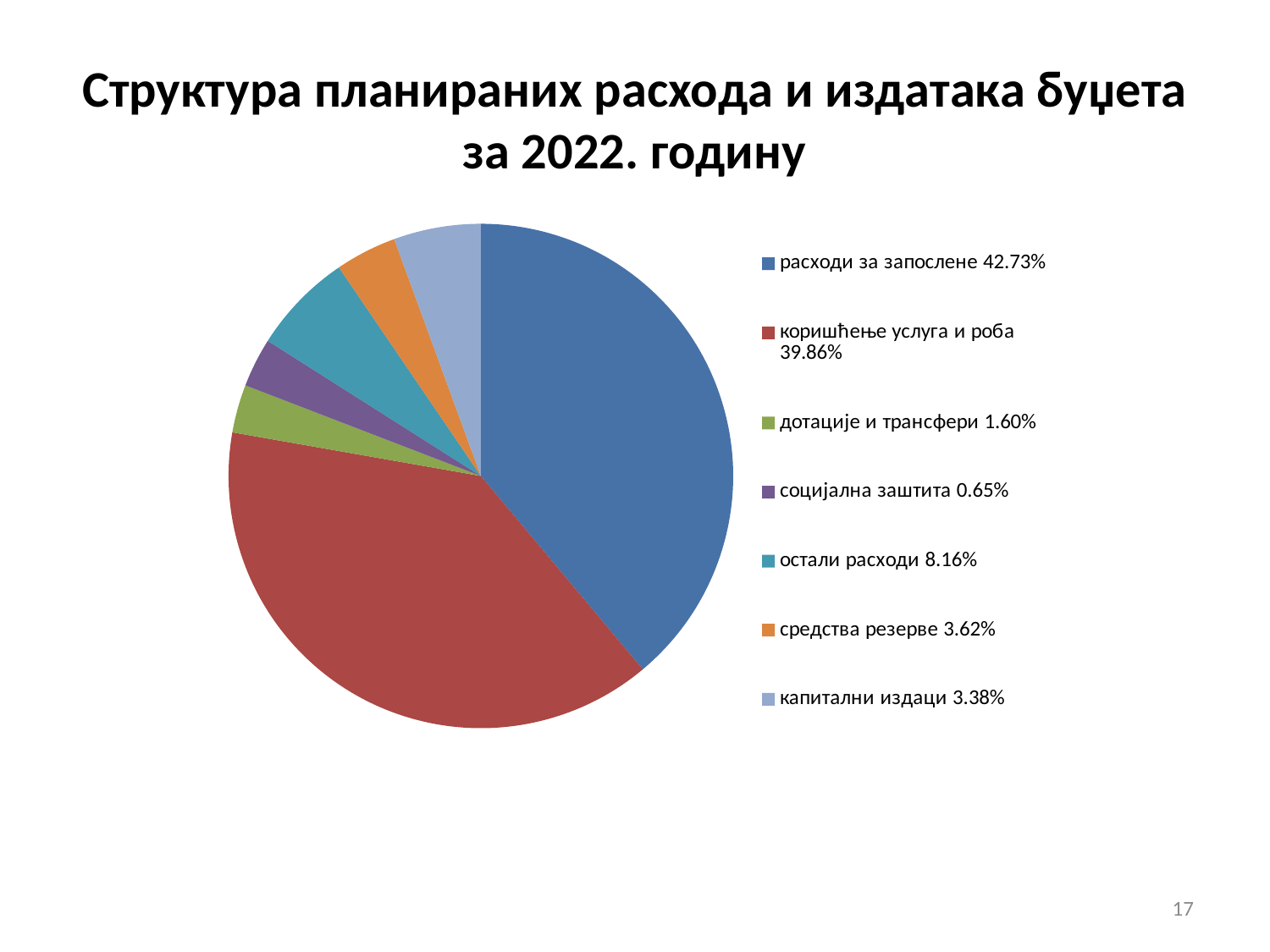
What percentage is shown for коришћење услуга и роба? 39.86% What share of the budget is planned for расходи за запослене? 42.73% What is the combined share of расходи за запослене and коришћење услуга и роба? 82.59% What is the difference in percentage points between расходи за запослене and коришћење услуга и роба? 2.87% What percentage is shown for капитални издаци? 3.38% Which category has the largest share of the pie? расходи за запослене Which category has the smallest share of the pie? социјална заштита How many categories does the pie chart have? 7 What is the title of the chart on the slide? Структура планираних расхода и издатака буџета за 2022. годину Which is larger, the share for средства резерве or the share for капитални издаци? средства резерве What kind of chart is shown on the slide? pie chart What percentage is shown for остали расходи? 8.16%